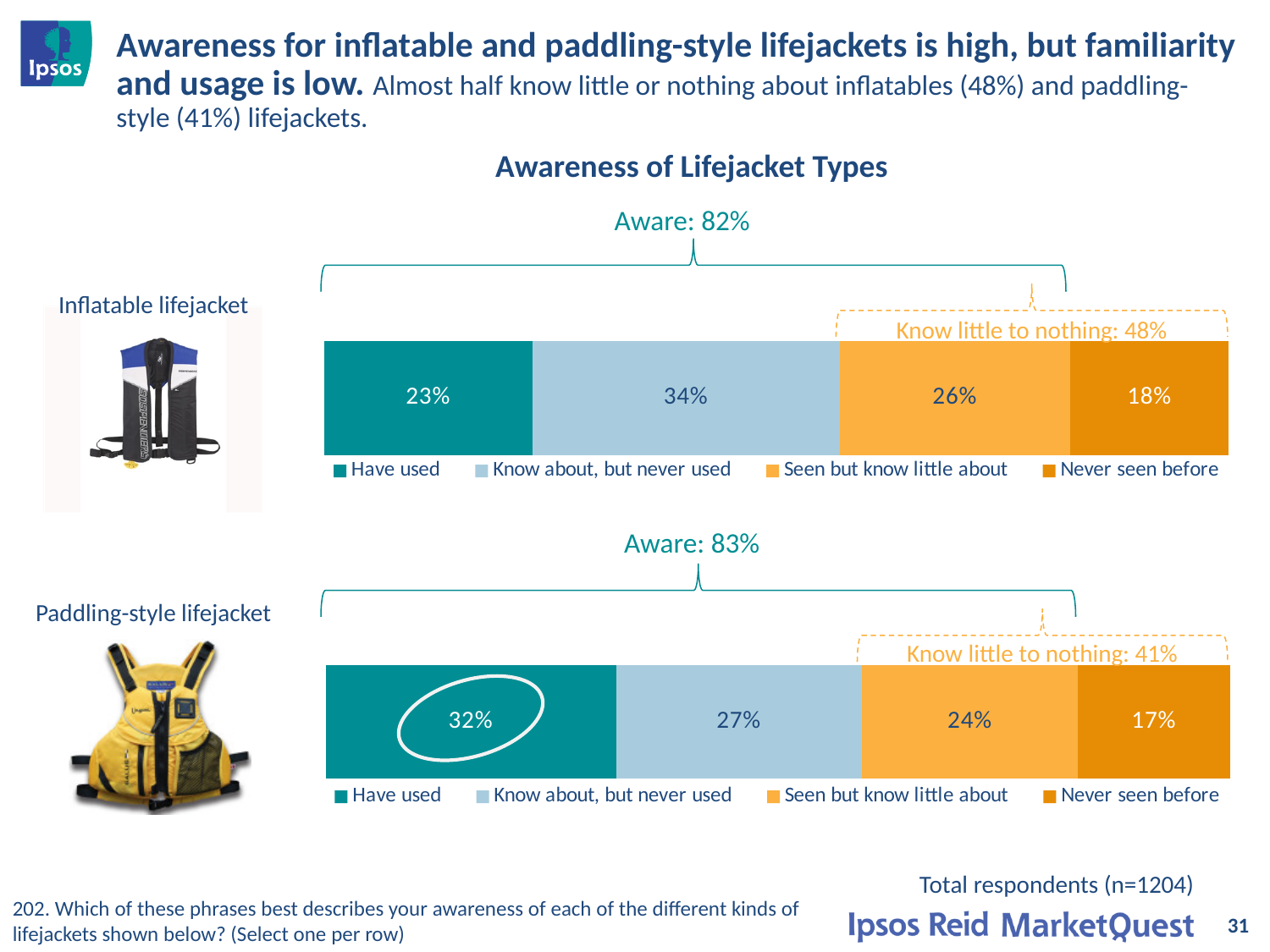
According to the Paddling-style lifejacket chart, what percentage of respondents know little to nothing about paddling-style lifejackets? 41% How many series does the legend list for each lifejacket chart? 4 In the Inflatable lifejacket chart, what percentage of respondents have used an inflatable lifejacket? 23% According to the Inflatable lifejacket chart, what percentage of respondents are aware of inflatable lifejackets? 82% In the Paddling-style lifejacket chart, what percentage of respondents have used a paddling-style lifejacket? 32% In the Inflatable lifejacket chart, which response category has the largest share? Know about, but never used In the Paddling-style lifejacket chart, which response category has the smallest share? Never seen before In the Paddling-style lifejacket chart, what percentage of respondents have never seen a paddling-style lifejacket before? 17% What kind of chart is used to show awareness of lifejacket types? Stacked bar chart What is the difference between the 'Have used' percentages for paddling-style lifejackets and inflatable lifejackets? 9 percentage points Which is larger: the 'Seen but know little about' share for inflatable lifejackets or for paddling-style lifejackets? Inflatable lifejackets In the Inflatable lifejacket chart, what percentage of respondents know about inflatable lifejackets but have never used them? 34%